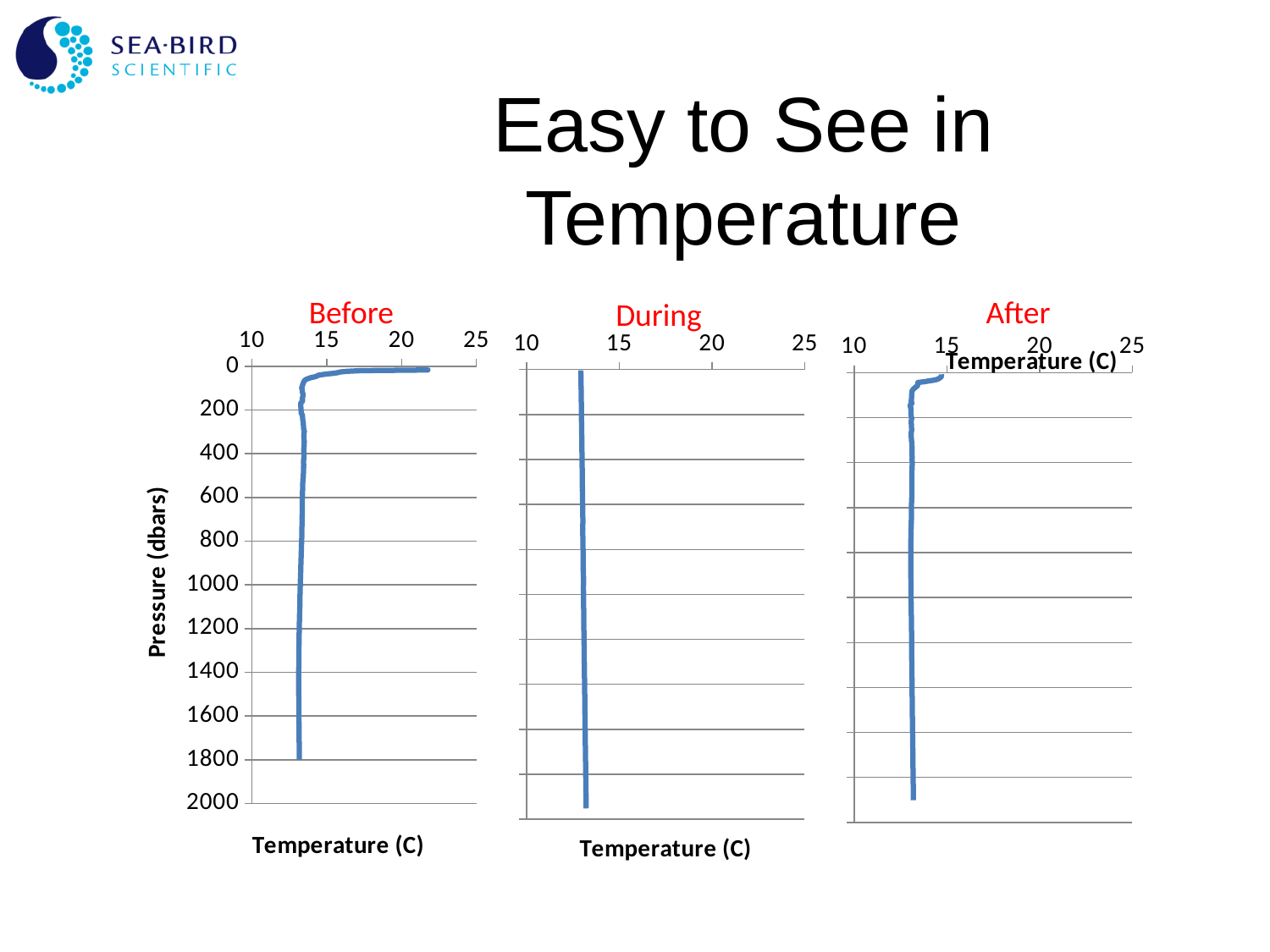
How many charts are shown on the slide? 3 Which chart shows the highest surface temperature: 'Before', 'During' or 'After'? Before What is the y-axis label on the 'Before' chart? Pressure (dbars) In the 'During' chart, is the temperature at a pressure of 1000 dbars greater or less than 15? less What are the titles of the three charts, from left to right? Before, During, After In the 'Before' chart, does the temperature rise or fall as pressure increases from 0 to 200 dbars? fall In the 'Before' chart, is the temperature at a pressure of 1000 dbars greater or less than 15? less In the 'During' chart, does the temperature change noticeably or stay roughly constant as pressure increases? stays roughly constant In the 'After' chart, is the temperature at a pressure of 1000 dbars greater or less than 15? less What is the maximum value shown on the x axis of the 'During' chart? 25 What kind of chart is the 'Before' chart? line chart